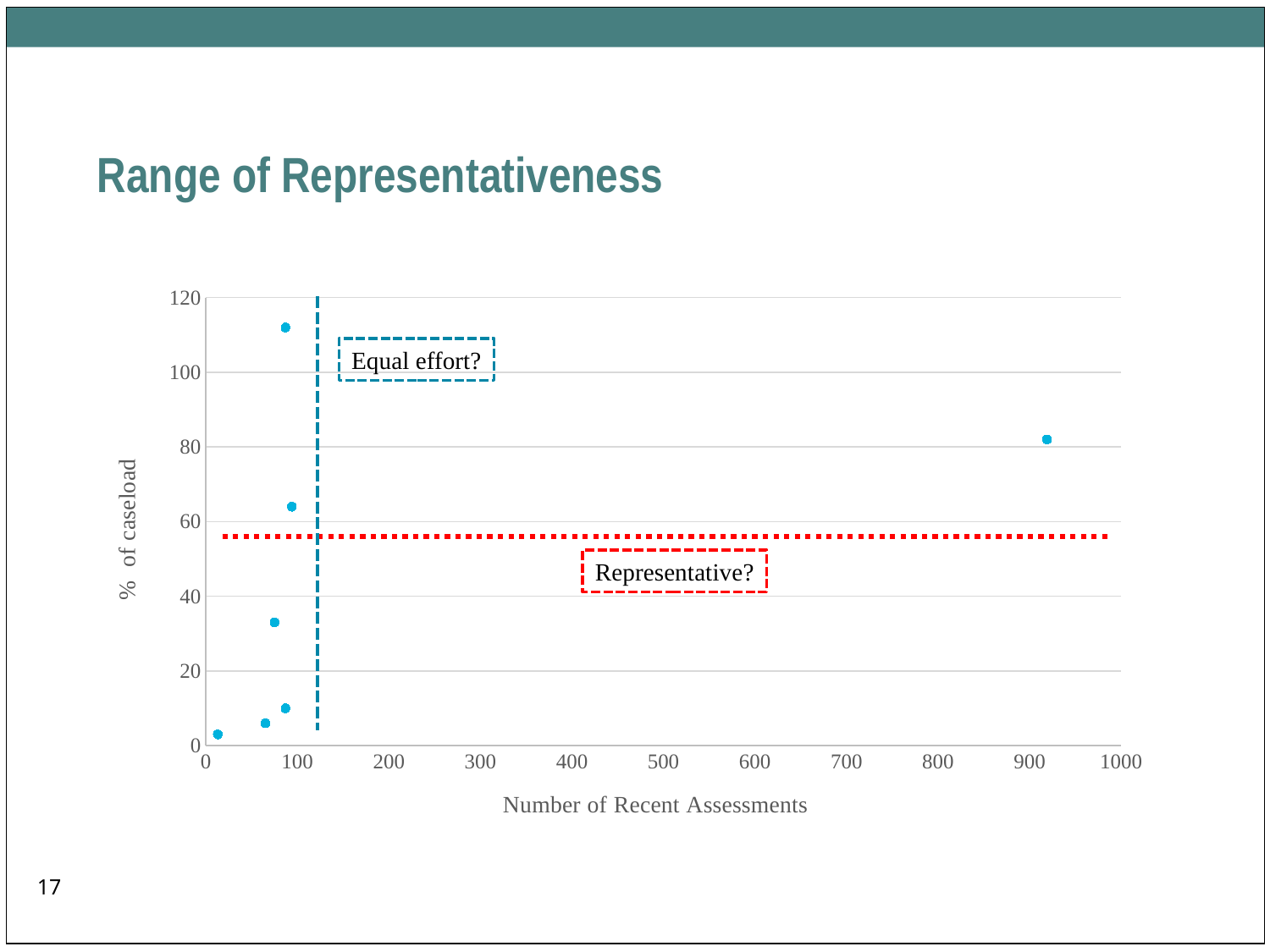
What is the label of the x axis? Number of Recent Assessments Are there more points to the left of the dashed vertical line or to the right of it? left How many points have a number of recent assessments greater than 500? 1 What is the label of the y axis? % of caseload How many data points are plotted on the chart? 7 Is the % of caseload for the lowest point on the chart greater or less than 20? less How many points have a % of caseload greater than 100? 1 Is the % of caseload for the highest point on the chart greater or less than 100? greater What kind of chart is shown on the slide? scatter chart Is the % of caseload for the point with the most recent assessments (around 900) greater or less than 60? greater